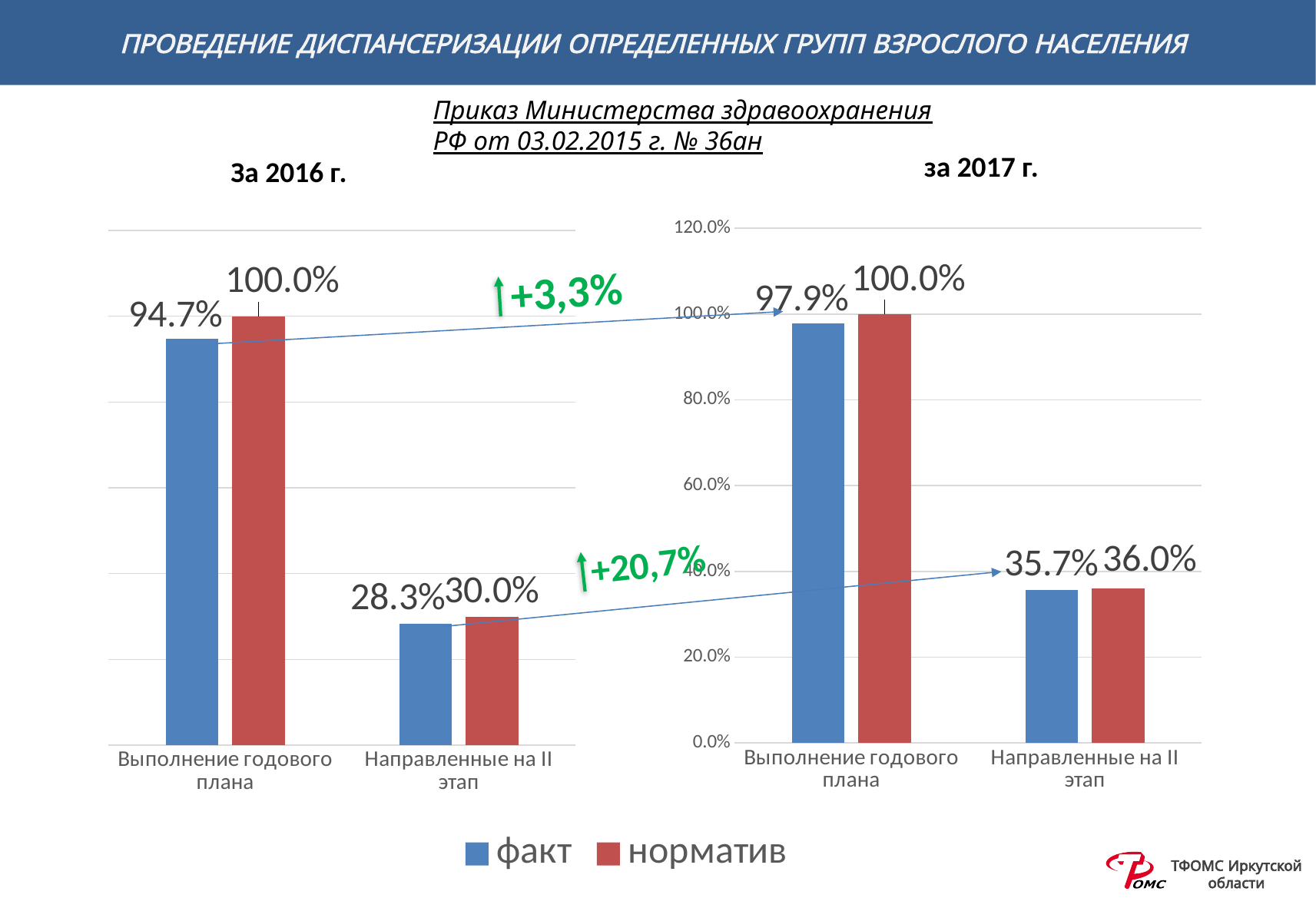
How many categories are shown on the x axis of the chart for 2016 (За 2016 г.)? 2 In the chart for 2016 (За 2016 г.), which category has the lowest факт value? Направленные на II этап In the chart for 2017 (за 2017 г.), what is the difference between the норматив and факт values for Направленные на II этап? 0.3 percentage points How many series does the legend list? 2 In the chart for 2017 (за 2017 г.), is the факт value for Направленные на II этап greater or less than 40.0%? less In the chart for 2016 (За 2016 г.), what is the факт value for Выполнение годового плана? 94.7% In the chart for 2017 (за 2017 г.), what is the факт value for Направленные на II этап? 35.7% In the chart for 2016 (За 2016 г.), what is the difference between the норматив and факт values for Выполнение годового плана? 5.3 percentage points In the chart for 2016 (За 2016 г.), what is the норматив value for Направленные на II этап? 30.0% What type of chart is used for the 2017 data (за 2017 г.)? Bar chart In the chart for 2017 (за 2017 г.), which is larger for Выполнение годового плана: факт or норматив? норматив In the chart for 2017 (за 2017 г.), what is the факт value for Выполнение годового плана? 97.9%